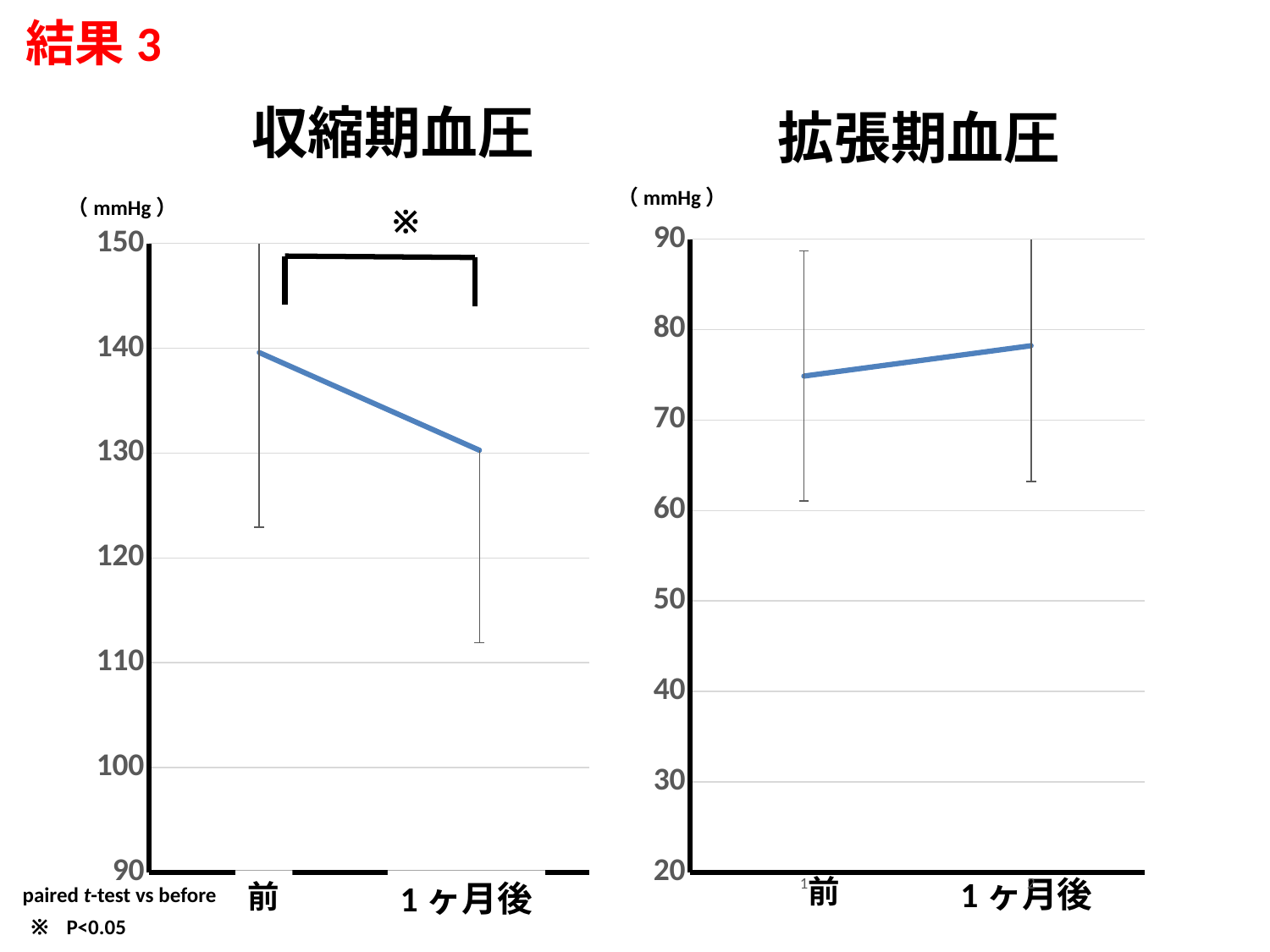
What kind of chart is the 収縮期血圧 chart? line chart On the 収縮期血圧 chart, is the value for 前 greater or less than 130? greater On the 拡張期血圧 chart, does the value rise or fall from 前 to 1ヶ月後? rise On the 拡張期血圧 chart, is the value for 前 greater or less than 70? greater On the 拡張期血圧 chart, is the value for 1ヶ月後 greater or less than 80? less How many points are plotted on the 拡張期血圧 chart? 2 What unit is shown on the y axis of both charts? mmHg On the 収縮期血圧 chart, which is larger, the value for 前 or for 1ヶ月後? 前 On the 拡張期血圧 chart, which is larger, the value for 前 or for 1ヶ月後? 1ヶ月後 What is the title of the chart on the right side of the slide? 拡張期血圧 On the 収縮期血圧 chart, does the value rise or fall from 前 to 1ヶ月後? fall